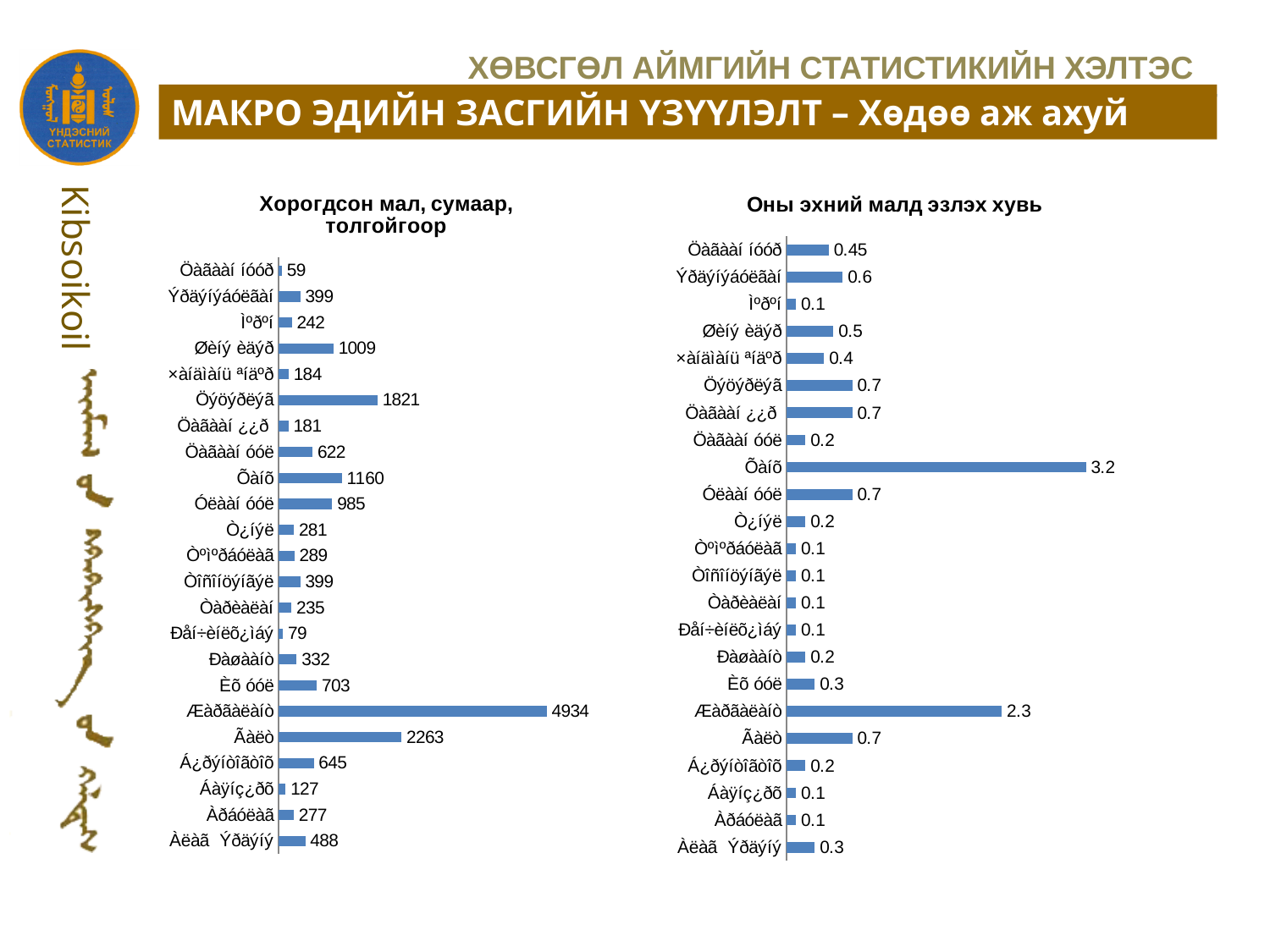
In the left chart 'Хорогдсон мал, сумаар, толгойгоор', what is the value of the bottommost bar? 488 What type of chart is the left chart titled 'Хорогдсон мал, сумаар, толгойгоор'? bar chart In the right chart 'Оны эхний малд эзлэх хувь', what is the highest value shown? 3.2 In the left chart 'Хорогдсон мал, сумаар, толгойгоор', what is the highest value shown? 4934 In the left chart 'Хорогдсон мал, сумаар, толгойгоор', what is the lowest value shown? 59 How many categories (bars) are shown in the left chart 'Хорогдсон мал, сумаар, толгойгоор'? 23 In the left chart 'Хорогдсон мал, сумаар, толгойгоор', what is the difference between the largest value (4934) and the second largest value (2263)? 2671 What is the title of the chart on the right side of the slide? Оны эхний малд эзлэх хувь In the left chart 'Хорогдсон мал, сумаар, толгойгоор', what is the value of the topmost bar? 59 In the right chart 'Оны эхний малд эзлэх хувь', what is the difference between the two largest values, 3.2 and 2.3? 0.9 In the right chart 'Оны эхний малд эзлэх хувь', what is the value of the topmost bar? 0.45 In the right chart 'Оны эхний малд эзлэх хувь', what is the value of the bottommost bar? 0.3